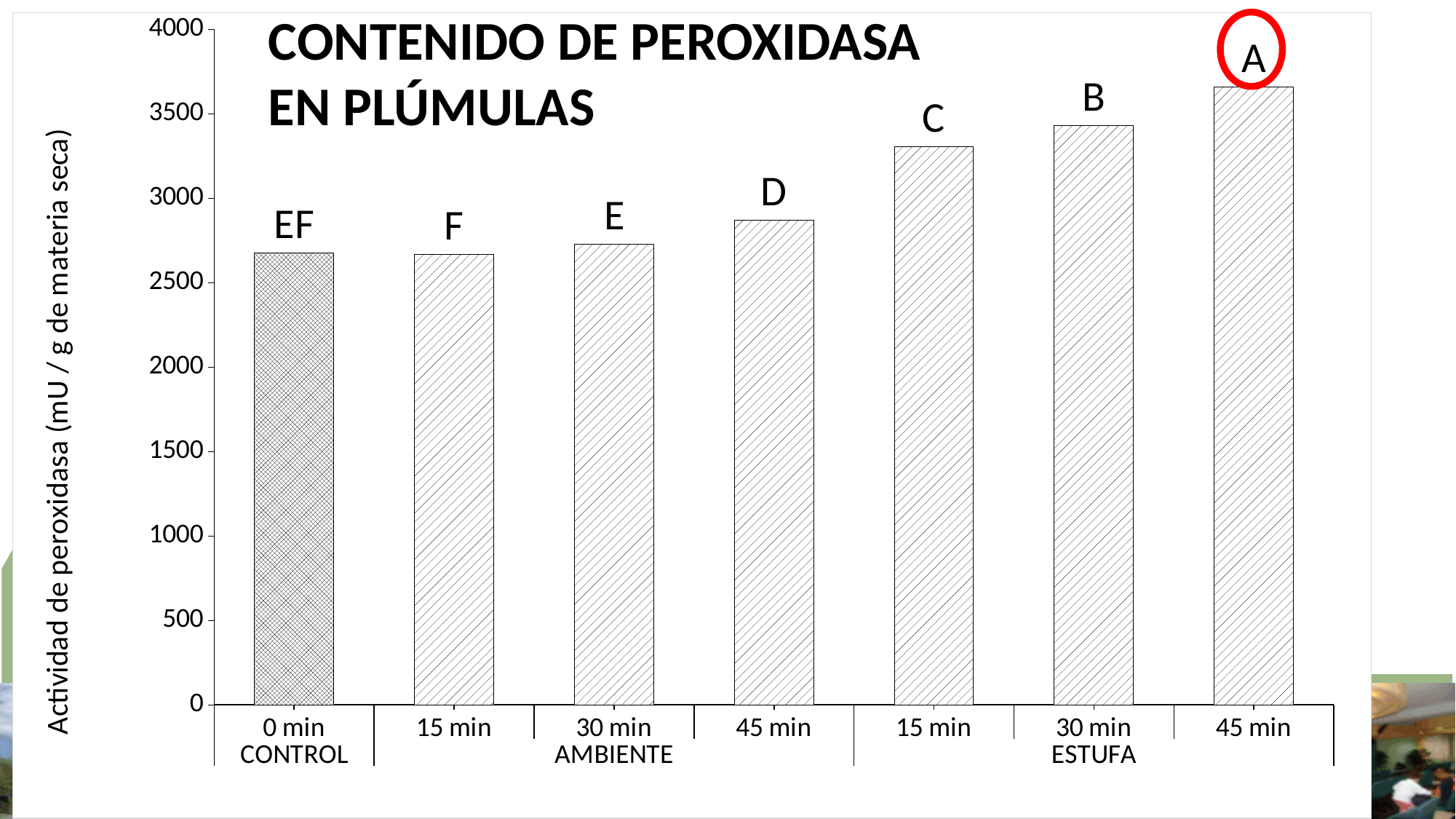
Is the value for 45 min ESTUFA greater or less than 3500? greater Is the value for 0 min CONTROL greater or less than 2500? greater Which letter labels the 45 min ESTUFA bar? A Which bar has the highest peroxidase activity? 45 min ESTUFA Is the value for 30 min AMBIENTE greater or less than 3000? less How many bars are plotted in the chart? 7 Do the values generally rise or fall from left to right across the bars? rise Which is larger, the value for 45 min ESTUFA or the value for 45 min AMBIENTE? 45 min ESTUFA What kind of chart is shown on the slide? bar chart What is the title of the chart? CONTENIDO DE PEROXIDASA EN PLÚMULAS